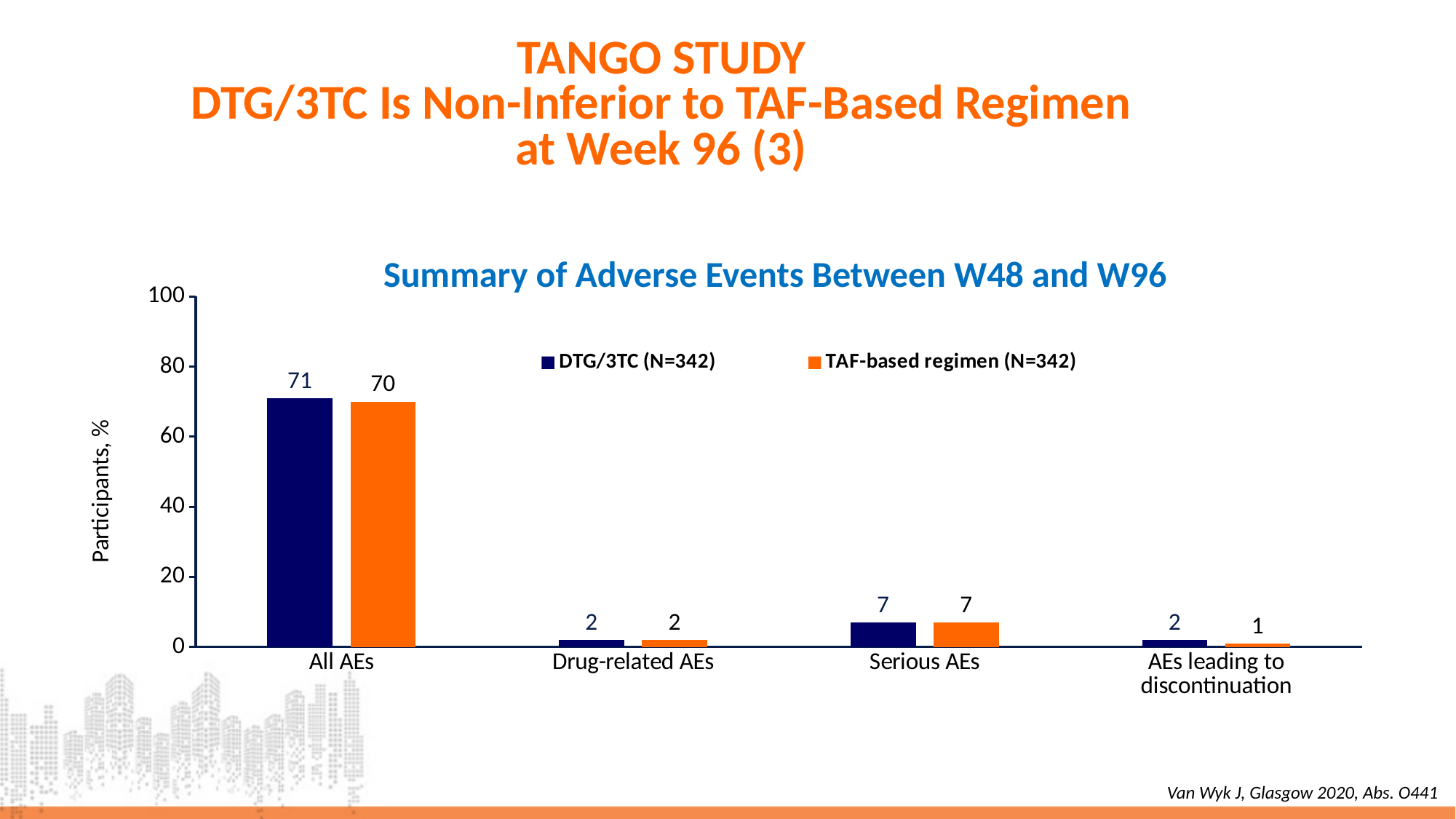
What is the value for DTG/3TC (N=342) in the Drug-related AEs category? 2 What is the title of the chart? Summary of Adverse Events Between W48 and W96 What is the value for TAF-based regimen (N=342) in the AEs leading to discontinuation category? 1 What is the difference between the DTG/3TC (N=342) and TAF-based regimen (N=342) values in the All AEs category? 1 How many categories are shown on the x axis of the chart? 4 How many series does the legend list? 2 What kind of chart is shown on the slide? Bar chart What is the value for DTG/3TC (N=342) in the All AEs category? 71 Which category has the highest value for the DTG/3TC (N=342) series? All AEs What is the value for TAF-based regimen (N=342) in the Serious AEs category? 7 Which category has the lowest value for the TAF-based regimen (N=342) series? AEs leading to discontinuation In the AEs leading to discontinuation category, which series has the larger value, DTG/3TC (N=342) or TAF-based regimen (N=342)? DTG/3TC (N=342)